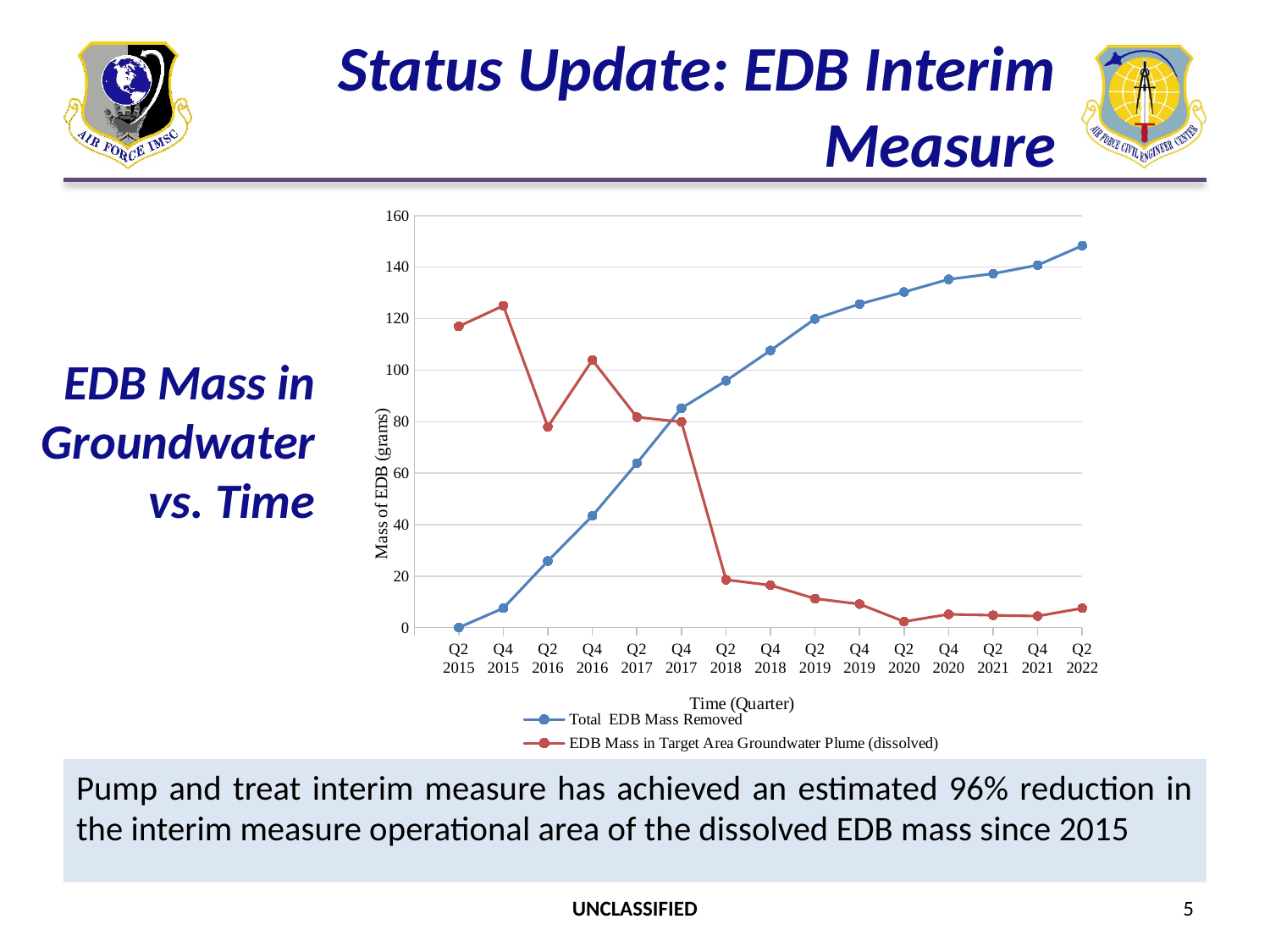
In Q2 2016, which series has the larger value: Total EDB Mass Removed or EDB Mass in Target Area Groundwater Plume (dissolved)? EDB Mass in Target Area Groundwater Plume (dissolved) Is the EDB Mass in Target Area Groundwater Plume (dissolved) in Q2 2018 greater or less than 40? less How many series does the legend list? 2 Is the EDB Mass in Target Area Groundwater Plume (dissolved) in Q2 2015 greater or less than 100? greater In which quarter is the Total EDB Mass Removed highest? Q2 2022 Is the Total EDB Mass Removed in Q2 2022 greater or less than 140? greater In which quarter is the EDB Mass in Target Area Groundwater Plume (dissolved) highest? Q4 2015 In Q2 2019, which series has the larger value: Total EDB Mass Removed or EDB Mass in Target Area Groundwater Plume (dissolved)? Total EDB Mass Removed In which quarter is the EDB Mass in Target Area Groundwater Plume (dissolved) lowest? Q2 2020 How many time points (quarters) are plotted along the x axis? 15 What kind of chart is shown on the slide? line chart Does the Total EDB Mass Removed rise or fall over time from Q2 2015 to Q2 2022? rise